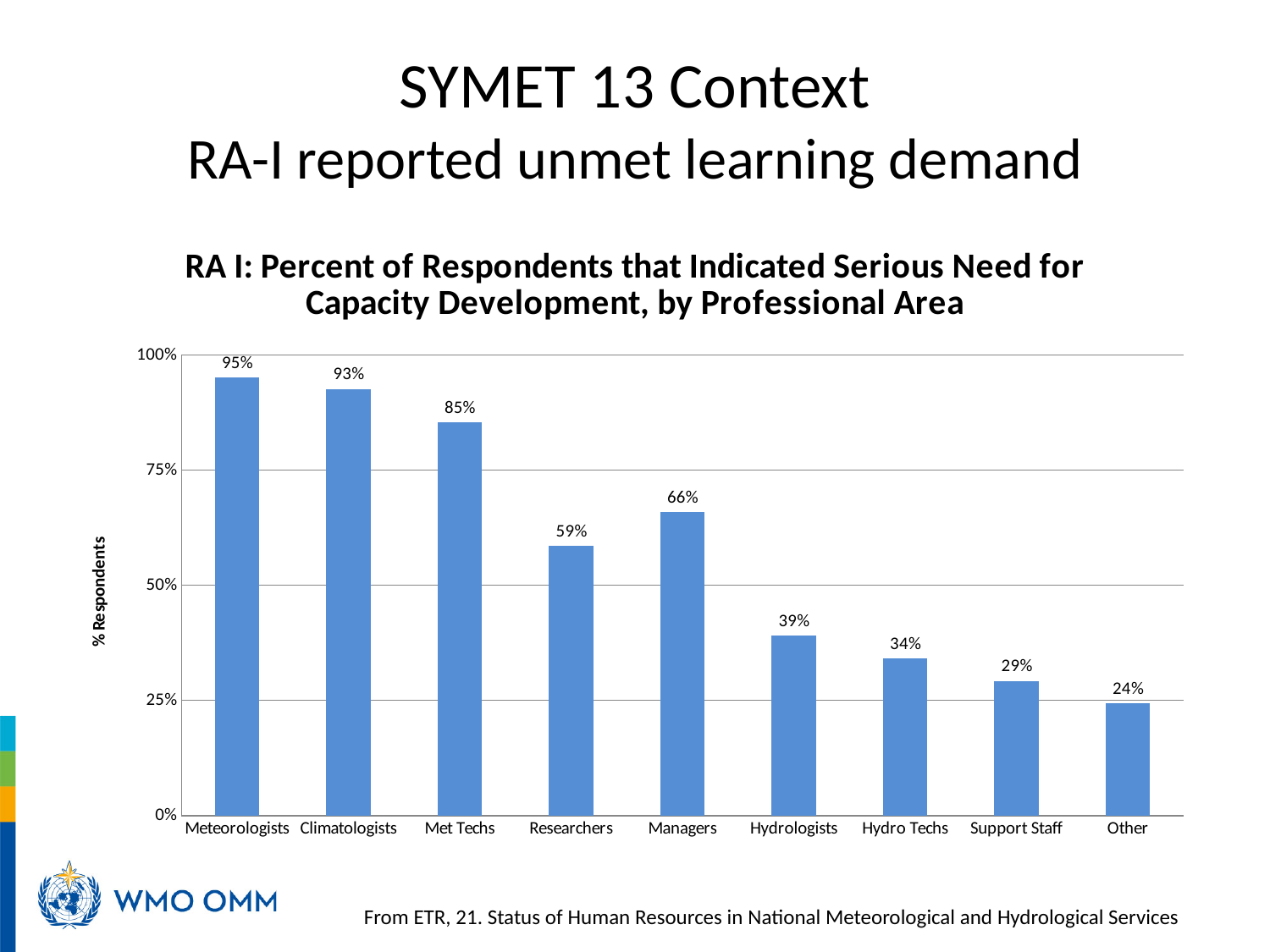
What is the value shown for Hydrologists? 39% Which professional area has the highest percentage of respondents? Meteorologists What is the value shown for Support Staff? 29% Which is larger, the value for Managers or the value for Researchers? Managers What is the difference between the values for Managers and Researchers? 7% How many professional areas are shown on the x axis? 9 What is the label of the y axis? % Respondents What is the difference between the values for Met Techs and Hydro Techs? 51% What percentage of respondents indicated serious need for capacity development among Meteorologists? 95% Is the value for Hydrologists greater or less than 50%? less What kind of chart is shown on the slide? Bar chart Which professional area has the lowest percentage of respondents? Other